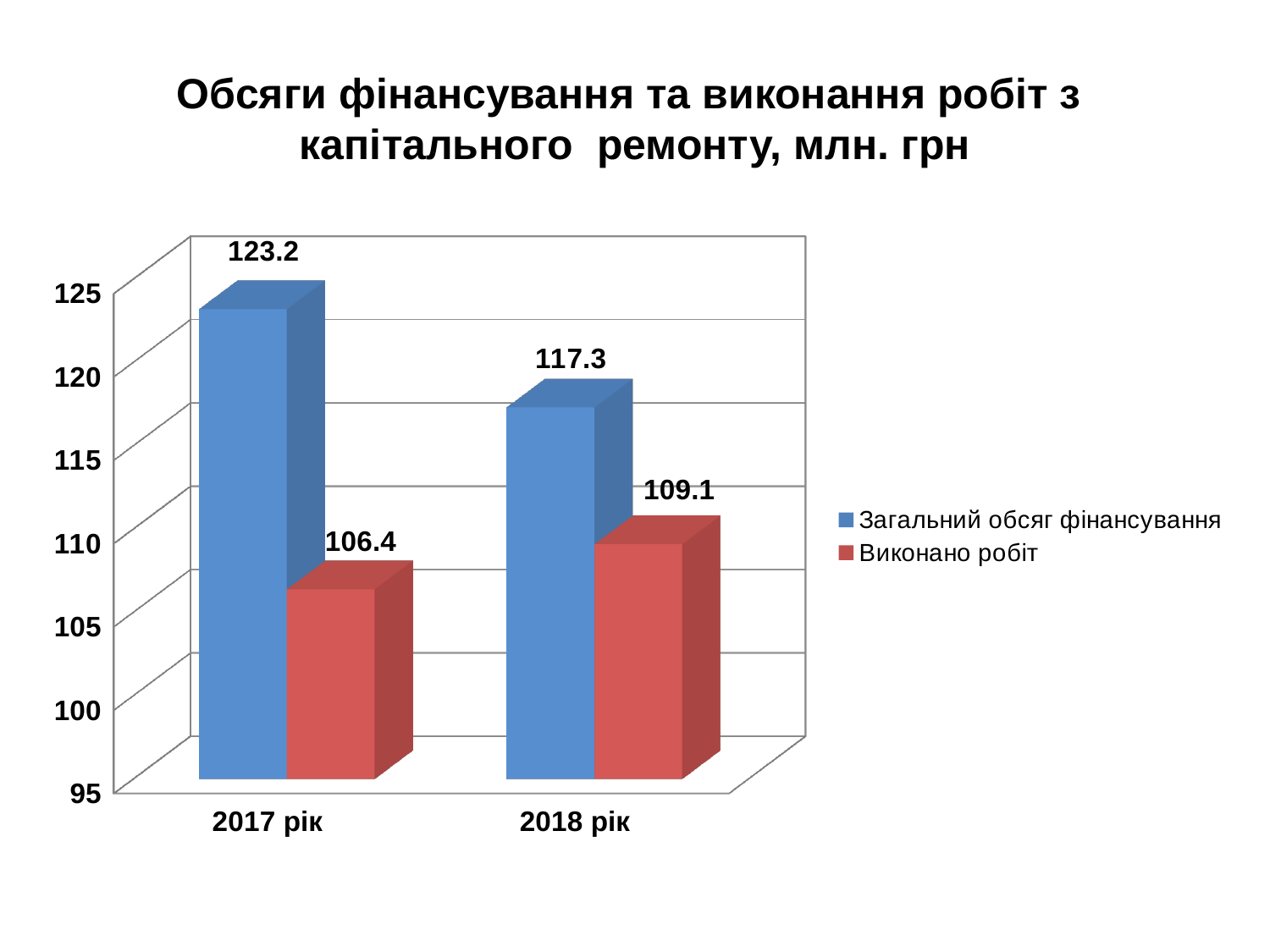
Which year has the lowest value for Виконано робіт? 2017 рік What is the value of Виконано робіт for 2018 рік? 109.1 How many series does the legend list? 2 What is the value of Загальний обсяг фінансування for 2017 рік? 123.2 What kind of chart is shown on the slide? Bar chart Does Загальний обсяг фінансування rise or fall from 2017 рік to 2018 рік? Fall What is the difference between Загальний обсяг фінансування and Виконано робіт in 2017 рік? 16.8 What is the value of Виконано робіт for 2017 рік? 106.4 What is the difference between Загальний обсяг фінансування and Виконано робіт in 2018 рік? 8.2 Which year has the highest value for Загальний обсяг фінансування? 2017 рік Which is larger: Виконано робіт in 2017 рік or Виконано робіт in 2018 рік? 2018 рік What is the value of Загальний обсяг фінансування for 2018 рік? 117.3